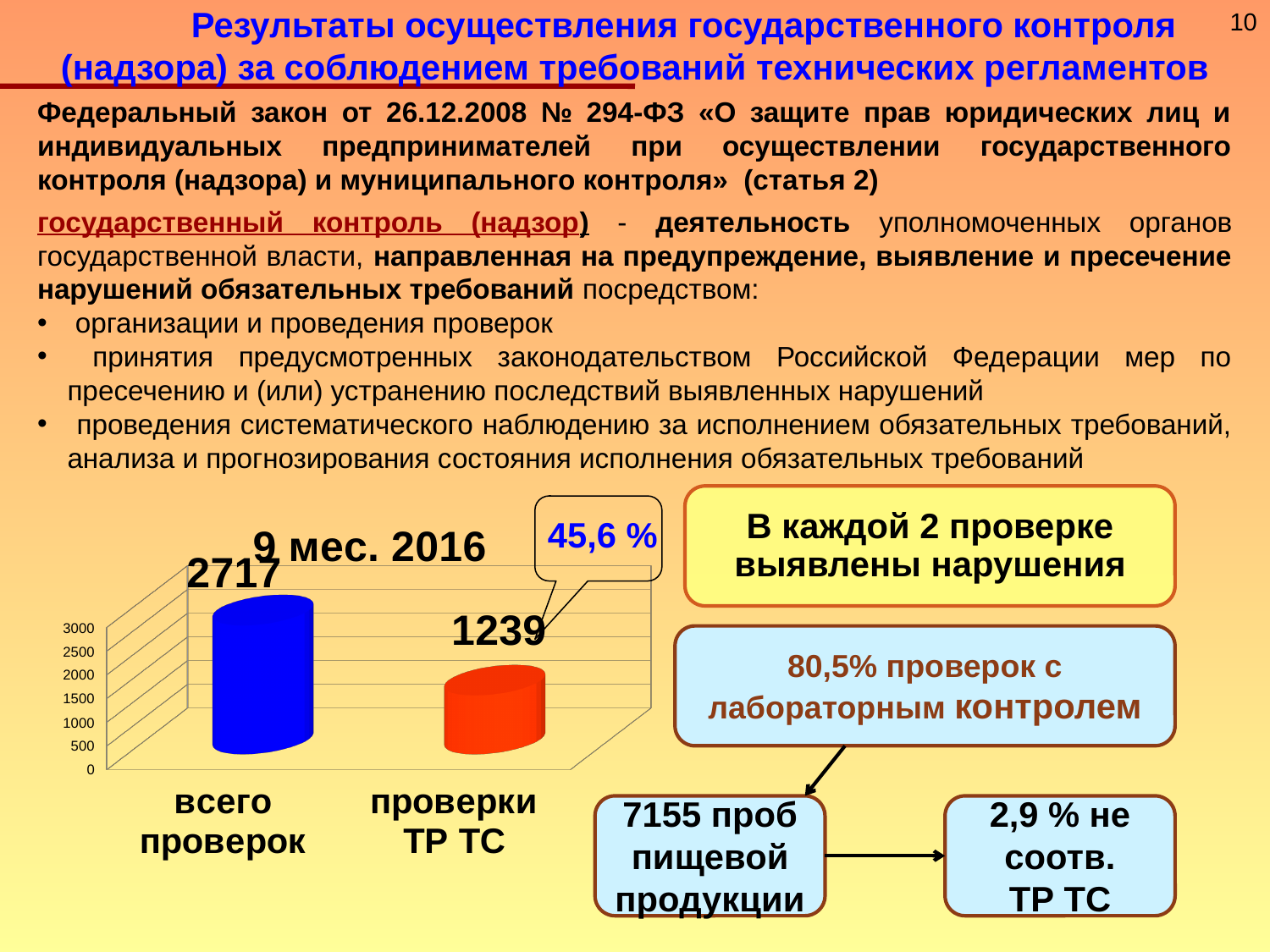
How many categories are shown in the chart? 2 What percentage is shown in the callout pointing to the "проверки ТР ТС" bar? 45,6 % Which is larger: the value for "всего проверок" or for "проверки ТР ТС"? всего проверок What is the difference between the values for "всего проверок" and "проверки ТР ТС"? 1478 What is the title of the chart? 9 мес. 2016 Is the value for "всего проверок" greater or less than 2500? greater Which category in the chart has the highest value? всего проверок What is the value for "всего проверок" in the chart? 2717 Which category in the chart has the lowest value? проверки ТР ТС Is the value for "проверки ТР ТС" greater or less than 1500? less What kind of chart is shown on the slide? bar chart What is the value for "проверки ТР ТС" in the chart? 1239